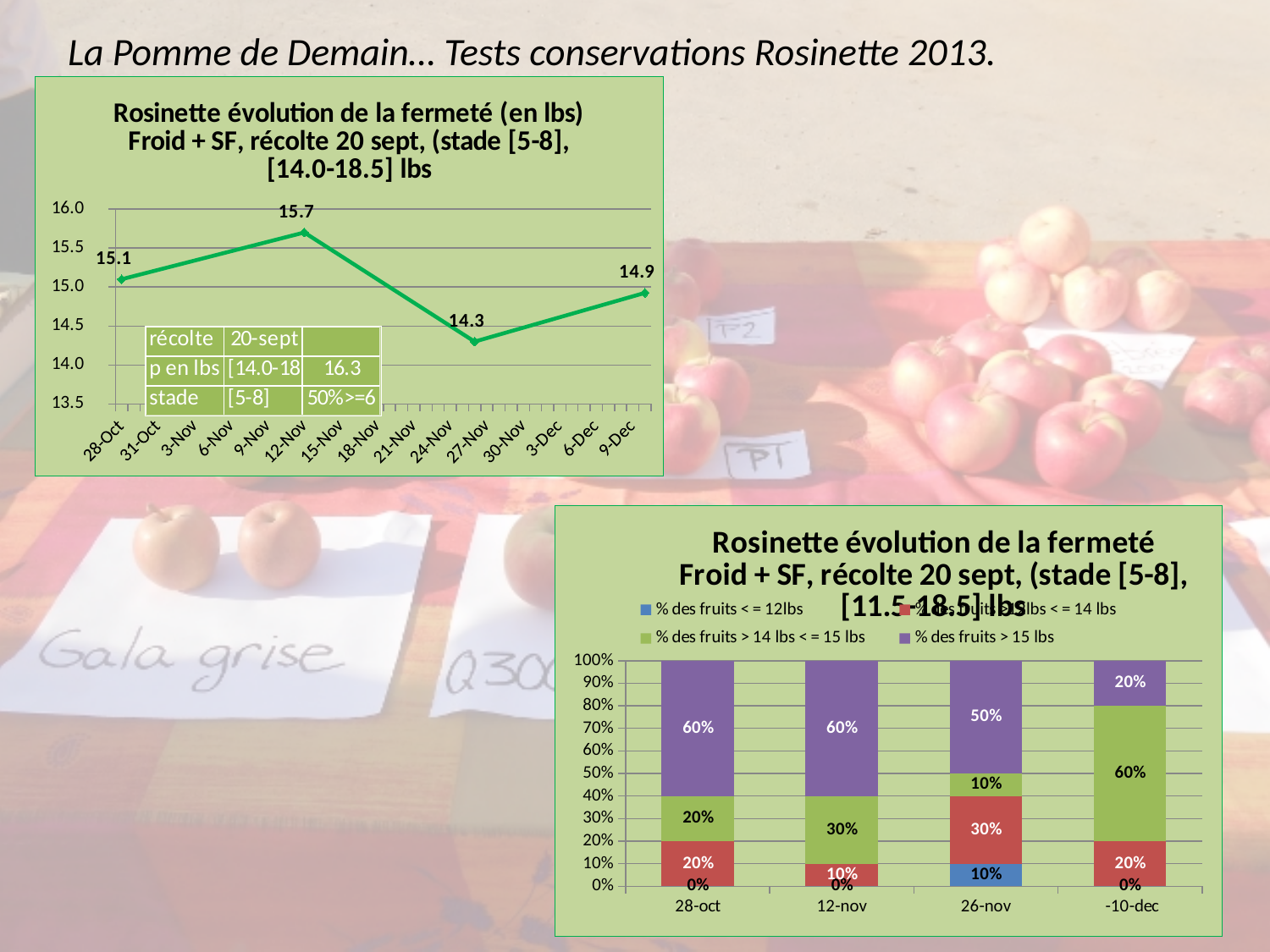
In the top-left line chart, is the last labelled value (14.9) greater or less than 15.0? less In the top-left line chart, which labelled point has the lowest value? 14.3 What type of chart is the top-left chart? line chart In the top-left line chart, what is the difference between the highest labelled value (15.7) and the lowest labelled value (14.3)? 1.4 In the bottom-right stacked bar chart, what percentage of fruits is > 14 lbs < = 15 lbs at -10-dec? 60% In the top-left line chart, what is the firmness value labelled at 12-Nov? 15.7 In the bottom-right stacked bar chart, how many series does the legend list? 4 In the bottom-right stacked bar chart, what is the percentage of fruits < = 12lbs at 26-nov? 10% In the bottom-right stacked bar chart, what percentage of fruits is > 15 lbs at 26-nov? 50% In the top-left line chart, what is the firmness value labelled at 28-Oct? 15.1 In the bottom-right stacked bar chart, which date has the largest share of fruits > 15 lbs: 26-nov or -10-dec? 26-nov In the bottom-right stacked bar chart, how many date categories are shown on the x axis? 4